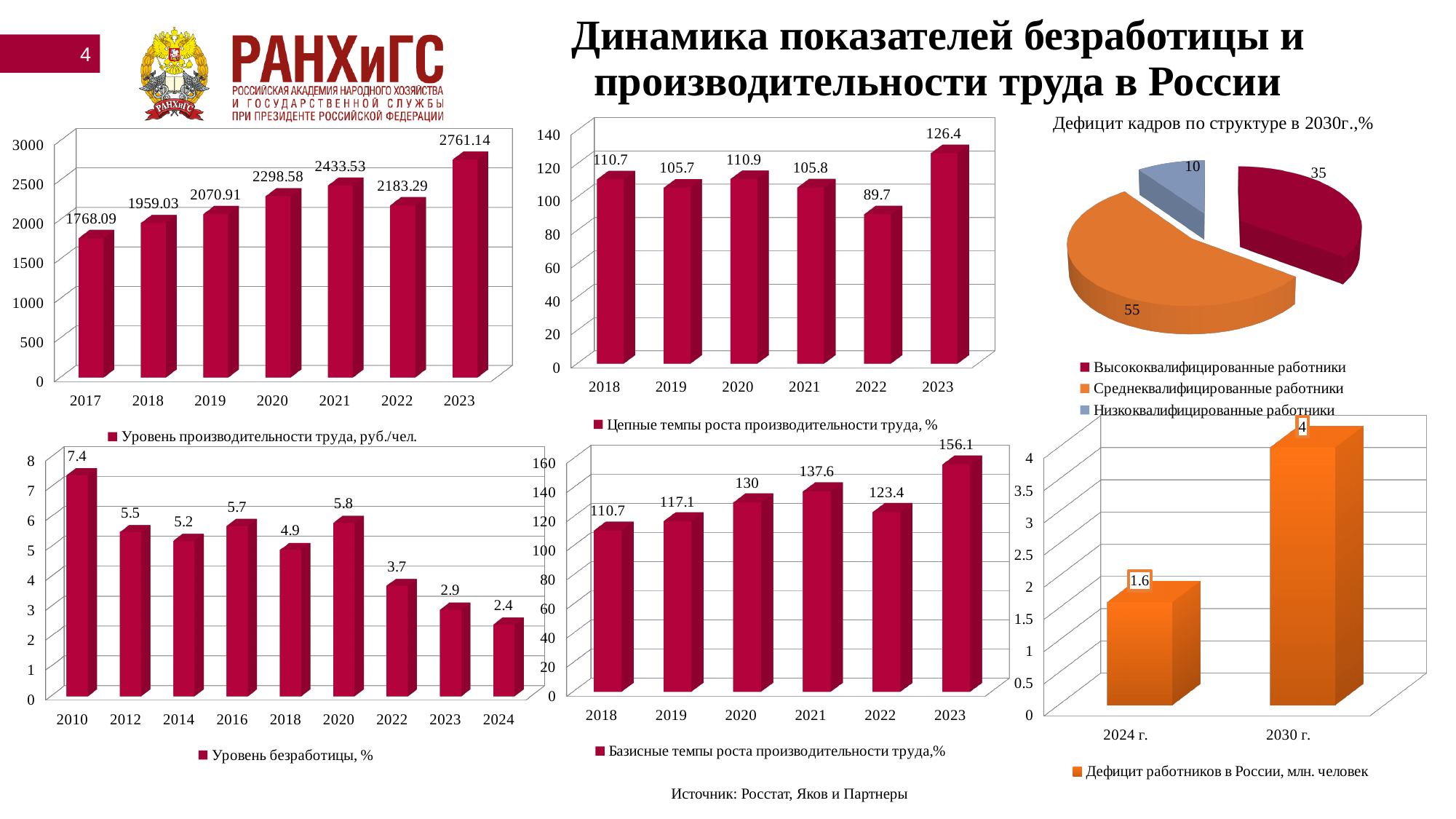
In the chart 'Уровень безработицы, %', how many years are shown on the x axis? 9 In the chart 'Базисные темпы роста производительности труда,%', which is larger: the value for 2021 or the value for 2022? 2021 In the chart 'Цепные темпы роста производительности труда, %', which year has the lowest value? 2022 How many slices does the pie chart 'Дефицит кадров по структуре в 2030г.,%' have? 3 In the chart 'Дефицит работников в России, млн. человек', what is the difference between the values for 2030 г. and 2024 г.? 2.4 In the chart 'Уровень производительности труда, руб./чел.', what is the value for 2020? 2298.58 In the chart 'Уровень безработицы, %', what is the value for 2024? 2.4 In the chart 'Цепные темпы роста производительности труда, %', what is the value for 2023? 126.4 In the pie chart 'Дефицит кадров по структуре в 2030г.,%', what is the share for Среднеквалифицированные работники? 55 In the chart 'Уровень производительности труда, руб./чел.', which year has the highest value? 2023 In the chart 'Уровень безработицы, %', what is the difference between the values for 2010 and 2024? 5 What type of chart is 'Дефицит работников в России, млн. человек'? Bar chart